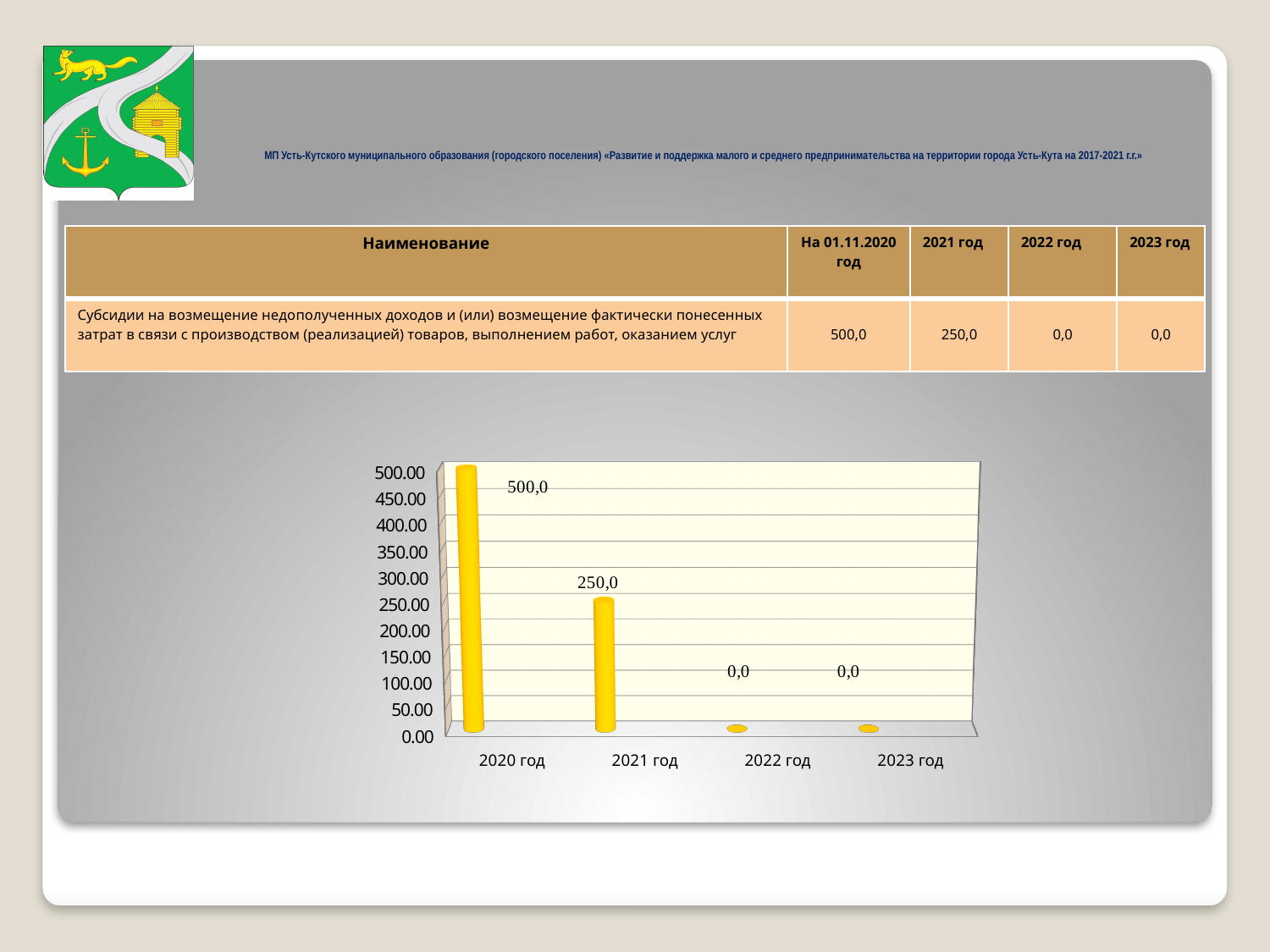
Which is larger, the value for 2020 год or the value for 2021 год? 2020 год Do the values rise or fall from 2020 год to 2023 год? fall What is the value shown for 2022 год? 0,0 What is the difference between the values for 2020 год and 2021 год? 250,0 What is the highest tick value shown on the vertical axis of the chart? 500.00 Which year has the highest value in the chart? 2020 год What is the value shown for 2021 год? 250,0 How many categories are shown on the x axis of the chart? 4 What kind of chart is shown on the slide? bar chart What is the value shown for 2020 год? 500,0 Is the value for 2021 год greater or less than 300.00? less What is the value shown for 2023 год? 0,0